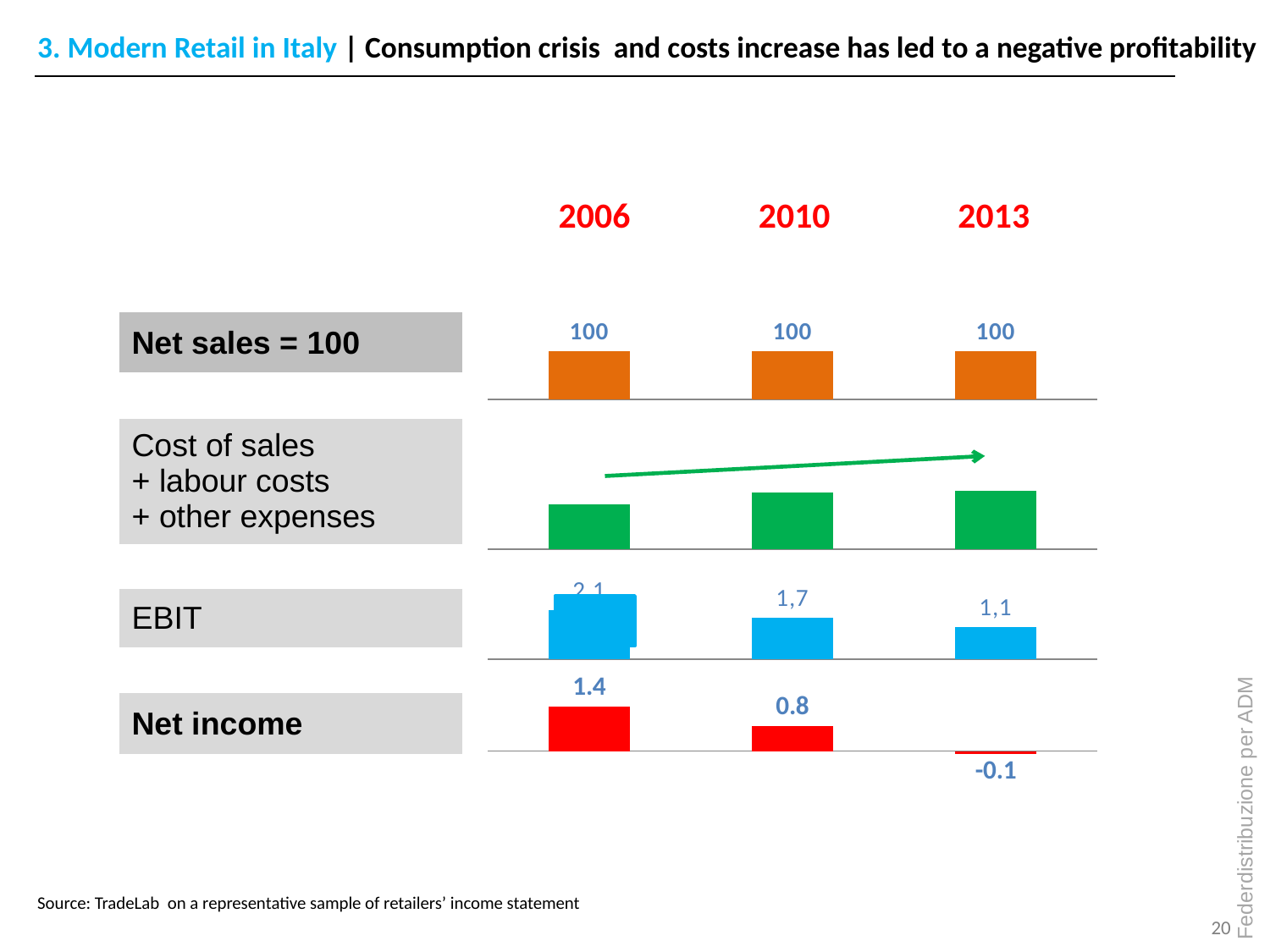
In the Net income chart, which year has the lowest value? 2013 In the EBIT chart, what is the value for 2010? 1,7 In the Net sales chart, what is the value for 2006? 100 In the EBIT chart, which year has the highest value? 2006 In the Net income chart, what is the value for 2013? -0.1 How many years are shown in the Net income chart? 3 In the EBIT chart, which is larger, the value for 2010 or the value for 2013? 2010 In the Net income chart, what is the value for 2010? 0.8 In the Net income chart, what is the value for 2006? 1.4 In the Cost of sales + labour costs + other expenses chart, do the bars rise or fall from 2006 to 2013? rise In the Net income chart, what is the difference between the 2006 and 2010 values? 0.6 In the EBIT chart, what is the value for 2013? 1,1